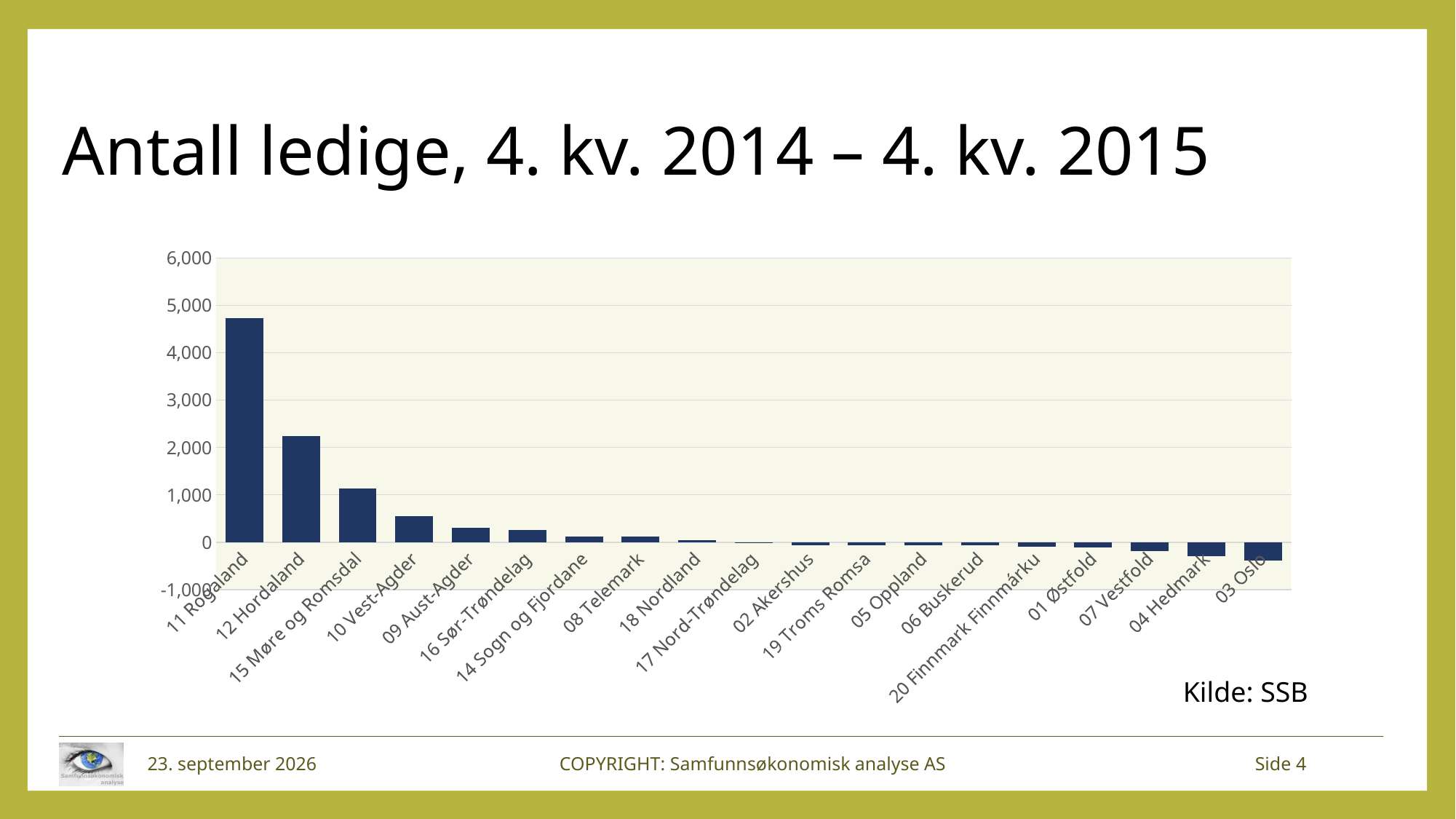
What is the title of the slide containing the chart? Antall ledige, 4. kv. 2014 – 4. kv. 2015 How many counties (bars) are shown in the chart? 19 What kind of chart is shown on the slide? Bar chart Which county has the lowest value in the chart? 03 Oslo Which has the larger value, 12 Hordaland or 15 Møre og Romsdal? 12 Hordaland Is the value for 03 Oslo greater or less than 0? less Is the value for 15 Møre og Romsdal greater or less than 1,000? greater Which county has the highest value in the chart? 11 Rogaland Is the value for 11 Rogaland greater or less than 4,000? greater Do the values rise or fall moving from left to right along the x axis? Fall